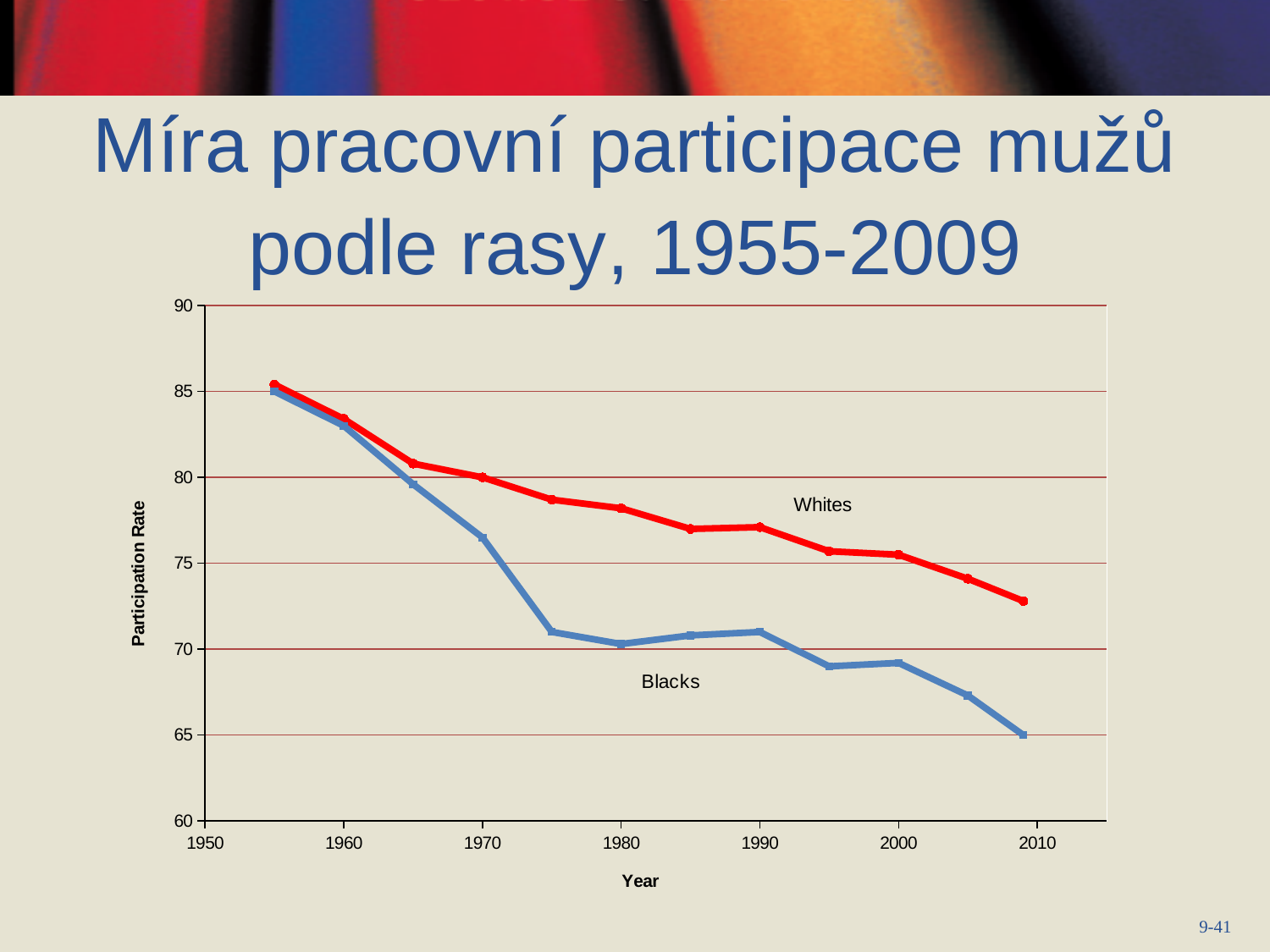
Is the value for Whites in 1990 greater or less than 75? greater Do the values for Whites rise or fall from 1955 to 2009? fall How many series are plotted on the chart? 2 Is the value for Blacks in 2005 greater or less than 70? less Do the values for Blacks rise or fall from 1955 to 2009? fall What kind of chart is shown on the slide? line chart Is the value for Blacks in 1975 greater or less than 75? less What is the label of the vertical axis? Participation Rate In 1990, which series has the higher participation rate, Whites or Blacks? Whites Which series is drawn in red? Whites